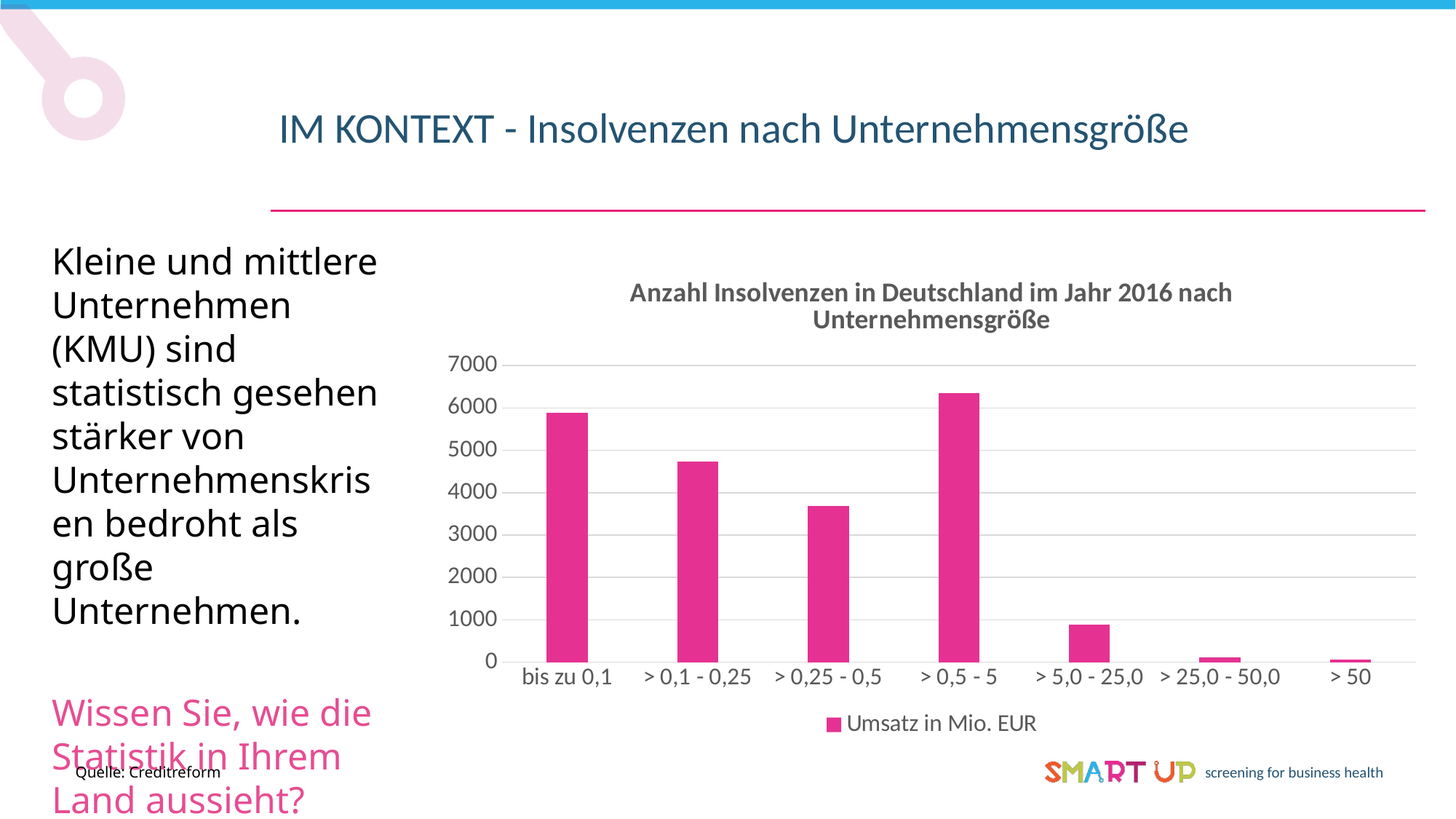
Which category has the highest number of insolvencies in the chart? > 0,5 - 5 Is the value for '> 5,0 - 25,0' greater or less than 1000? less What kind of chart is shown on the slide? bar chart Is the value for '> 0,5 - 5' greater or less than 6000? greater How many company-size categories are shown on the x axis of the chart? 7 What series name is shown in the chart legend? Umsatz in Mio. EUR Which is larger, the value for 'bis zu 0,1' or the value for '> 0,1 - 0,25'? bis zu 0,1 What is the title of the chart? Anzahl Insolvenzen in Deutschland im Jahr 2016 nach Unternehmensgröße Is the value for 'bis zu 0,1' greater or less than 5000? greater How many series does the chart legend list? 1